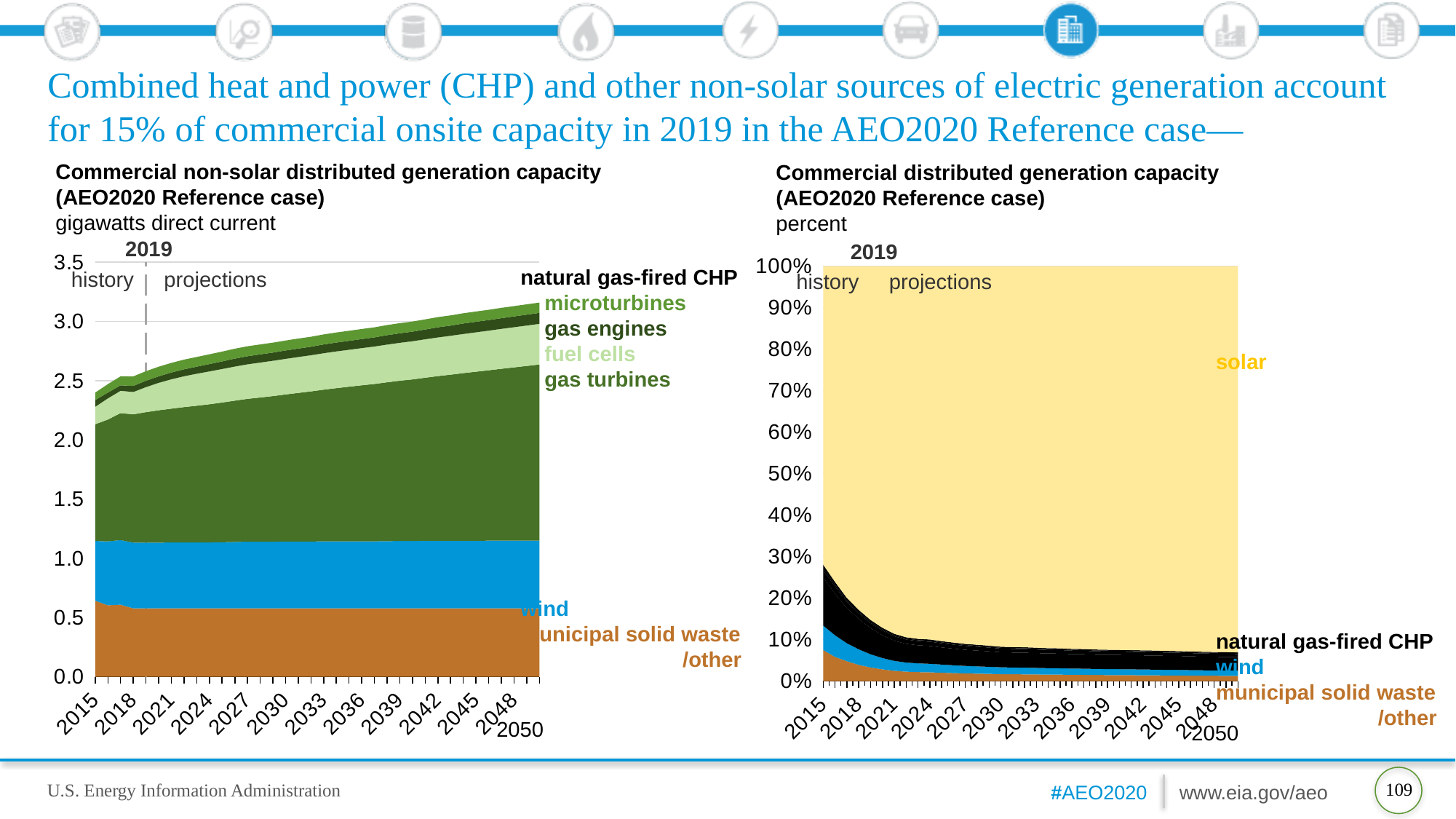
In the left chart, 'Commercial non-solar distributed generation capacity', is the total capacity in 2050 greater or less than 3.0? greater In the right chart, 'Commercial distributed generation capacity', is the solar share in 2050 greater or less than 90%? greater In the left chart, 'Commercial non-solar distributed generation capacity', is the total capacity in 2015 greater or less than 2.5? less What kind of chart is the left chart, 'Commercial non-solar distributed generation capacity'? stacked area chart In the left chart, 'Commercial non-solar distributed generation capacity', which year separates history from projections? 2019 In the left chart, 'Commercial non-solar distributed generation capacity', does total capacity rise or fall from 2015 to 2050? rise In the right chart, 'Commercial distributed generation capacity', which category has the largest share in 2050? solar In the left chart, 'Commercial non-solar distributed generation capacity', which of the four natural gas-fired CHP types has the largest capacity? gas turbines In the right chart, 'Commercial distributed generation capacity', does the share of natural gas-fired CHP rise or fall from 2015 to 2050? fall What kind of chart is the right chart, 'Commercial distributed generation capacity'? stacked area chart In the left chart, 'Commercial non-solar distributed generation capacity', which category is larger in 2050: gas turbines or fuel cells? gas turbines In the left chart, 'Commercial non-solar distributed generation capacity', what unit is shown on the y axis? gigawatts direct current